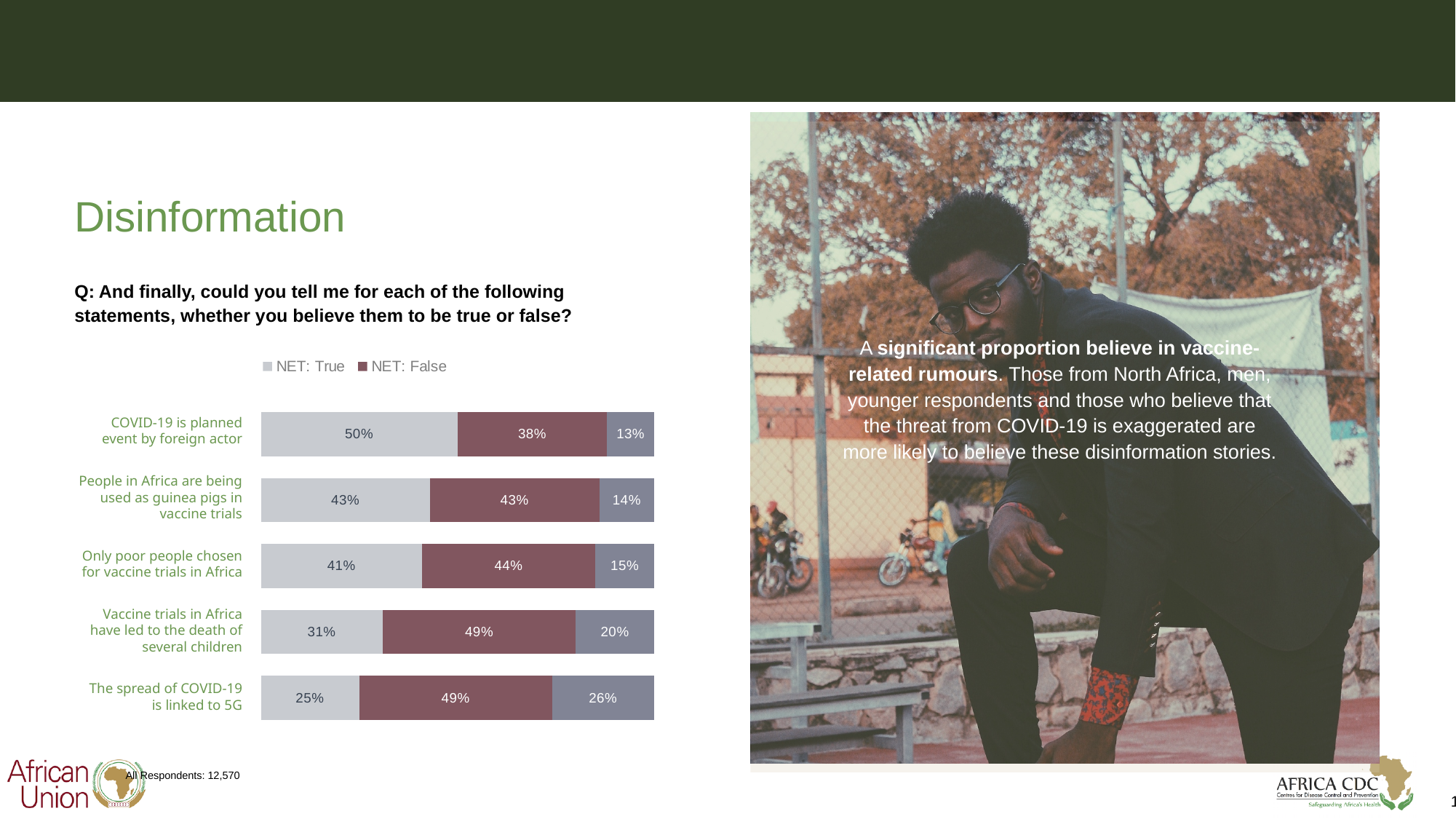
What is the difference between the NET: True and NET: False values for 'COVID-19 is planned event by foreign actor'? 12% For 'People in Africa are being used as guinea pigs in vaccine trials', is the NET: True value larger than, smaller than, or equal to the NET: False value? Equal What percentage of respondents believe it is true that COVID-19 is a planned event by a foreign actor (NET: True)? 50% How many statements are shown in the chart? 5 Which statement has the lowest NET: True value? The spread of COVID-19 is linked to 5G Which statement has the highest NET: True value? COVID-19 is planned event by foreign actor Which is larger: the NET: False value for 'Vaccine trials in Africa have led to the death of several children' or the NET: False value for 'COVID-19 is planned event by foreign actor'? Vaccine trials in Africa have led to the death of several children What is the NET: True value for 'Vaccine trials in Africa have led to the death of several children'? 31% What is the NET: False value for 'Only poor people chosen for vaccine trials in Africa'? 44% How many series does the chart legend list? 2 What is the NET: False value for the statement 'The spread of COVID-19 is linked to 5G'? 49% What type of chart is shown on the slide? Stacked bar chart